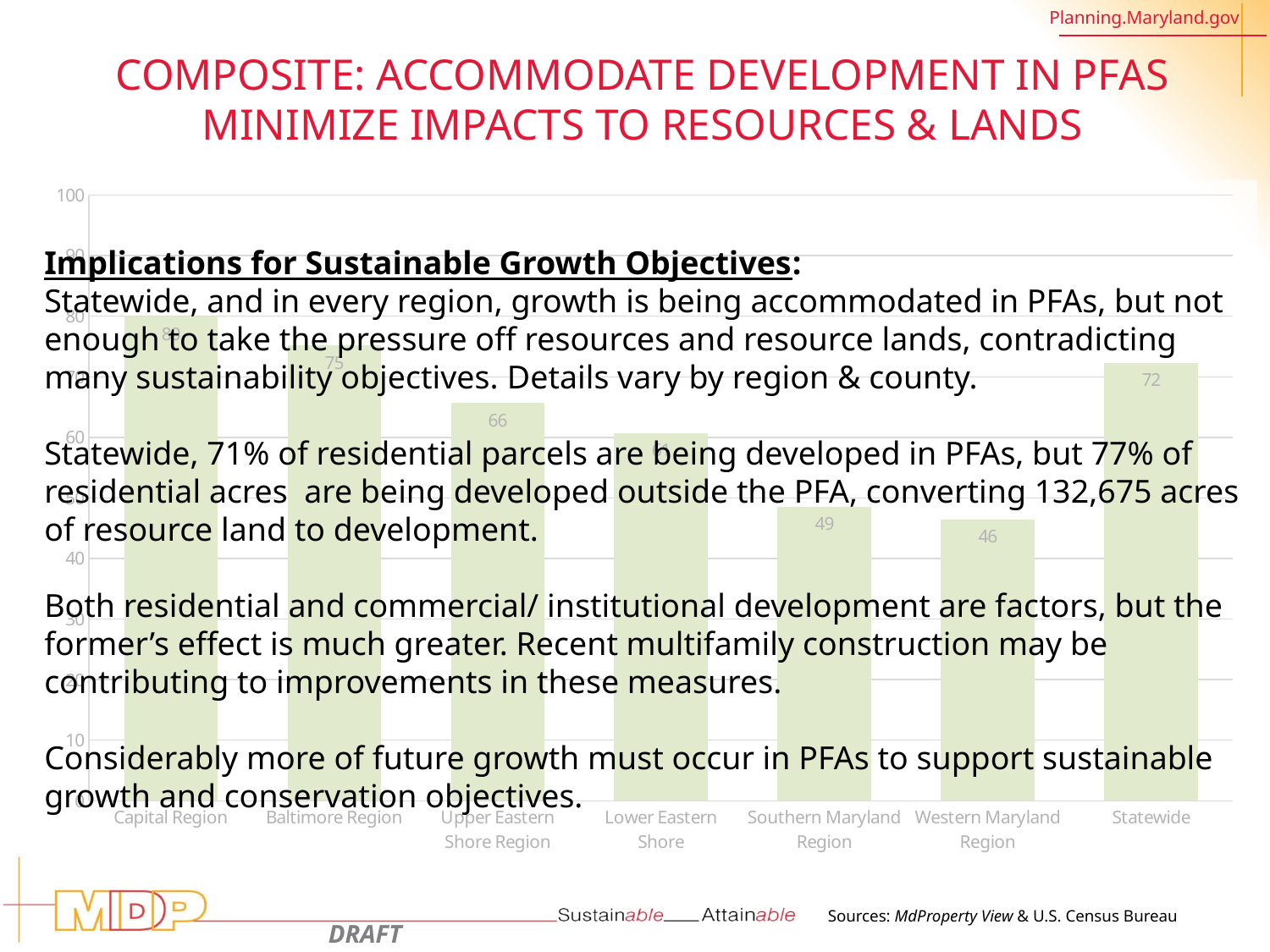
What kind of chart is shown on the slide? bar chart What is the value for the Western Maryland Region? 46 What is the value for the Baltimore Region? 75 What is the difference between the Baltimore Region and the Upper Eastern Shore Region values? 9 Which category has the highest value? Capital Region What is the Statewide value? 72 Which is larger, the Baltimore Region value or the Statewide value? Baltimore Region Is the value for the Lower Eastern Shore greater or less than 50? greater How many categories are shown on the x axis of the chart? 7 What is the value for the Upper Eastern Shore Region? 66 Which category has the lowest value? Western Maryland Region What is the value for the Southern Maryland Region? 49